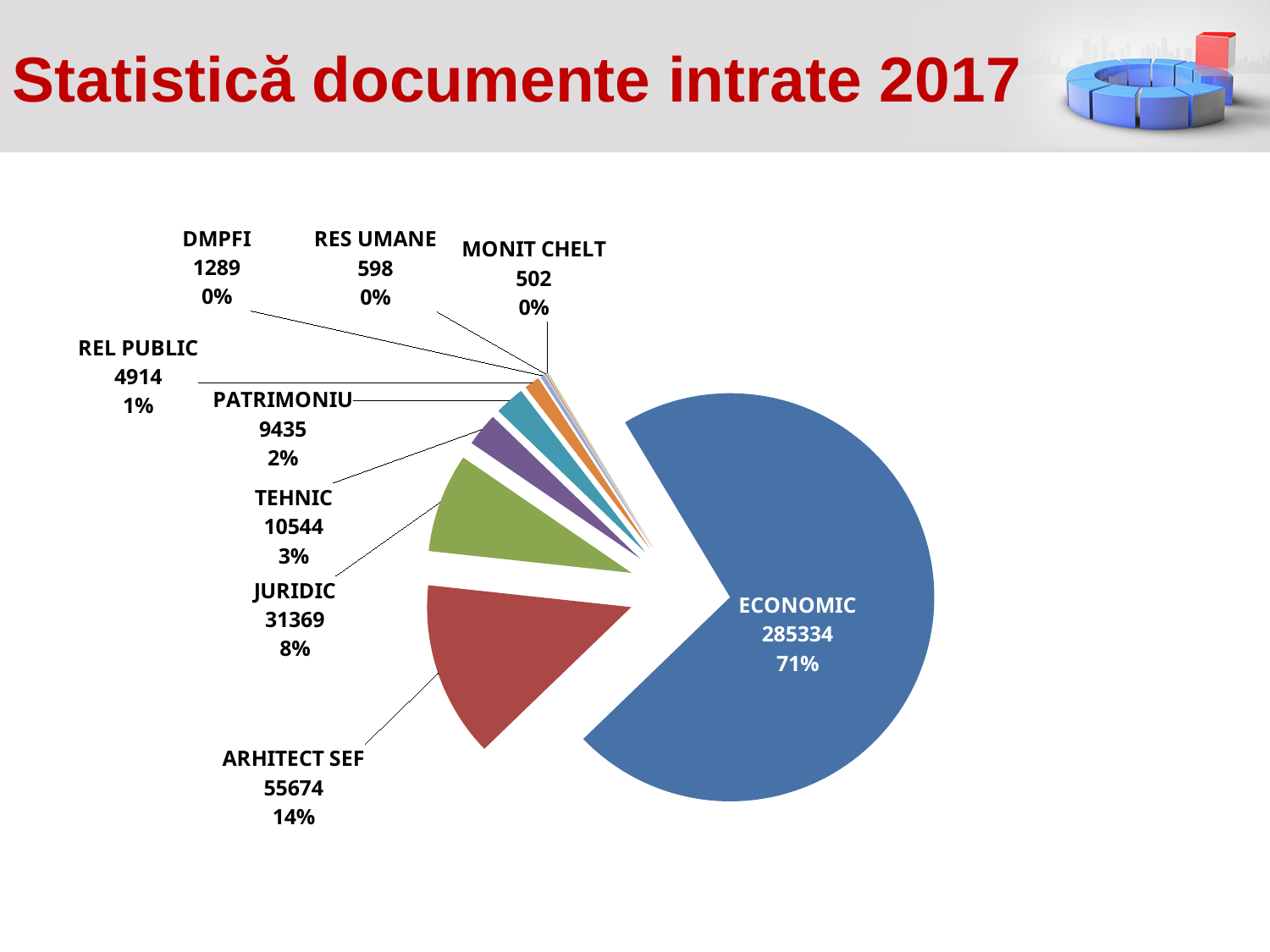
Which category has the largest slice? ECONOMIC How many categories are shown in the pie chart? 9 What share of the pie does ECONOMIC represent? 71% What is the difference between the values for ARHITECT SEF and JURIDIC? 24305 Which category has the smallest value? MONIT CHELT What share of the pie does ARHITECT SEF represent? 14% What is the value for ARHITECT SEF? 55674 What type of chart is shown on the slide? pie chart What is the value for JURIDIC? 31369 What is the value for ECONOMIC? 285334 What is the value for PATRIMONIU? 9435 Which is larger, the value for TEHNIC or the value for PATRIMONIU? TEHNIC